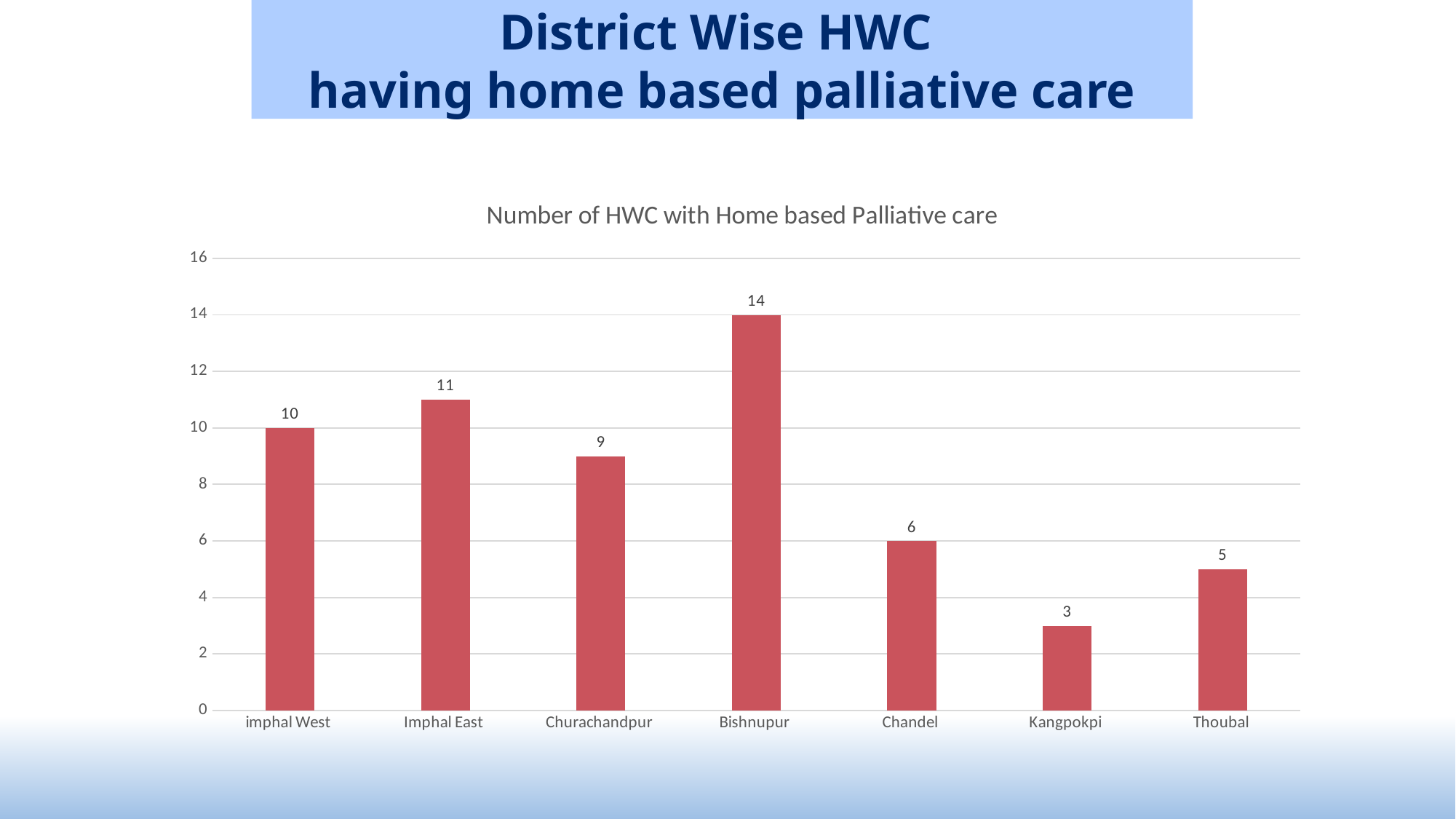
What is the title of the chart? Number of HWC with Home based Palliative care What is the value shown for Churachandpur? 9 What is the value shown for Kangpokpi? 3 How many districts are shown on the x axis? 7 What is the difference between the values for Bishnupur and Chandel? 8 What is the number of HWC with home based palliative care in Bishnupur? 14 Which district has the lowest number of HWC with home based palliative care? Kangpokpi Which has a larger value, Thoubal or Chandel? Chandel Which district has the highest number of HWC with home based palliative care? Bishnupur Is the value for Imphal East greater or less than 10? greater What is the difference between the values for Imphal East and Imphal West? 1 What type of chart is shown on the slide? Bar chart